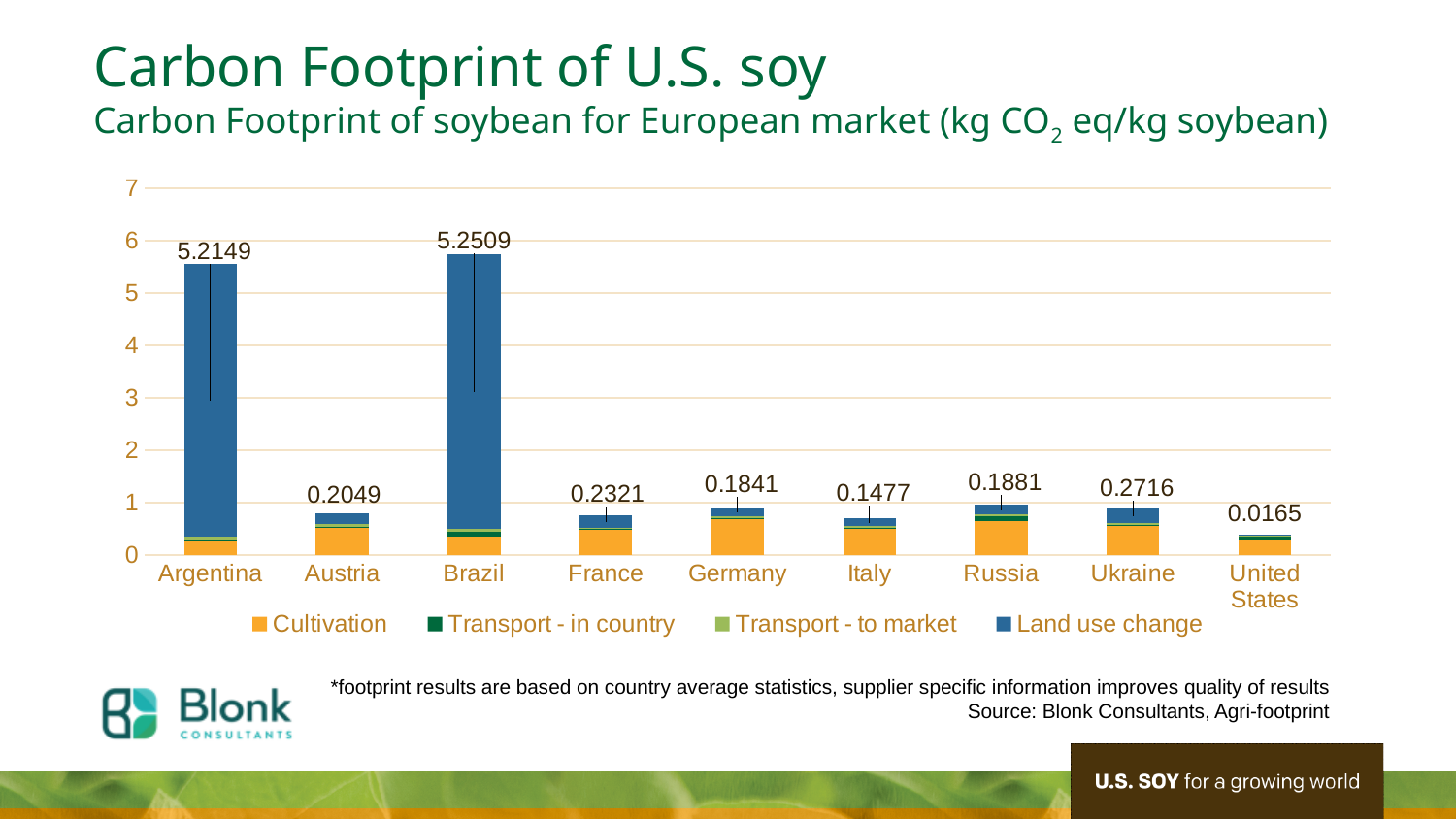
How many series does the chart legend list? 4 Which country has the lowest labelled value on the chart? United States Which country has the highest labelled value on the chart? Brazil What kind of chart is shown on the slide? Stacked bar chart Which series is shown in blue in the chart legend? Land use change What value is labelled on the bar for Argentina? 5.2149 What value is labelled on the bar for Ukraine? 0.2716 Is the total height of the bar for Argentina greater or less than 5? greater How many countries are shown on the x axis of the chart? 9 What value is labelled on the bar for the United States? 0.0165 Is the total height of the bar for Germany greater or less than 1? less What is the difference between the labelled values for Brazil and Argentina? 0.0360